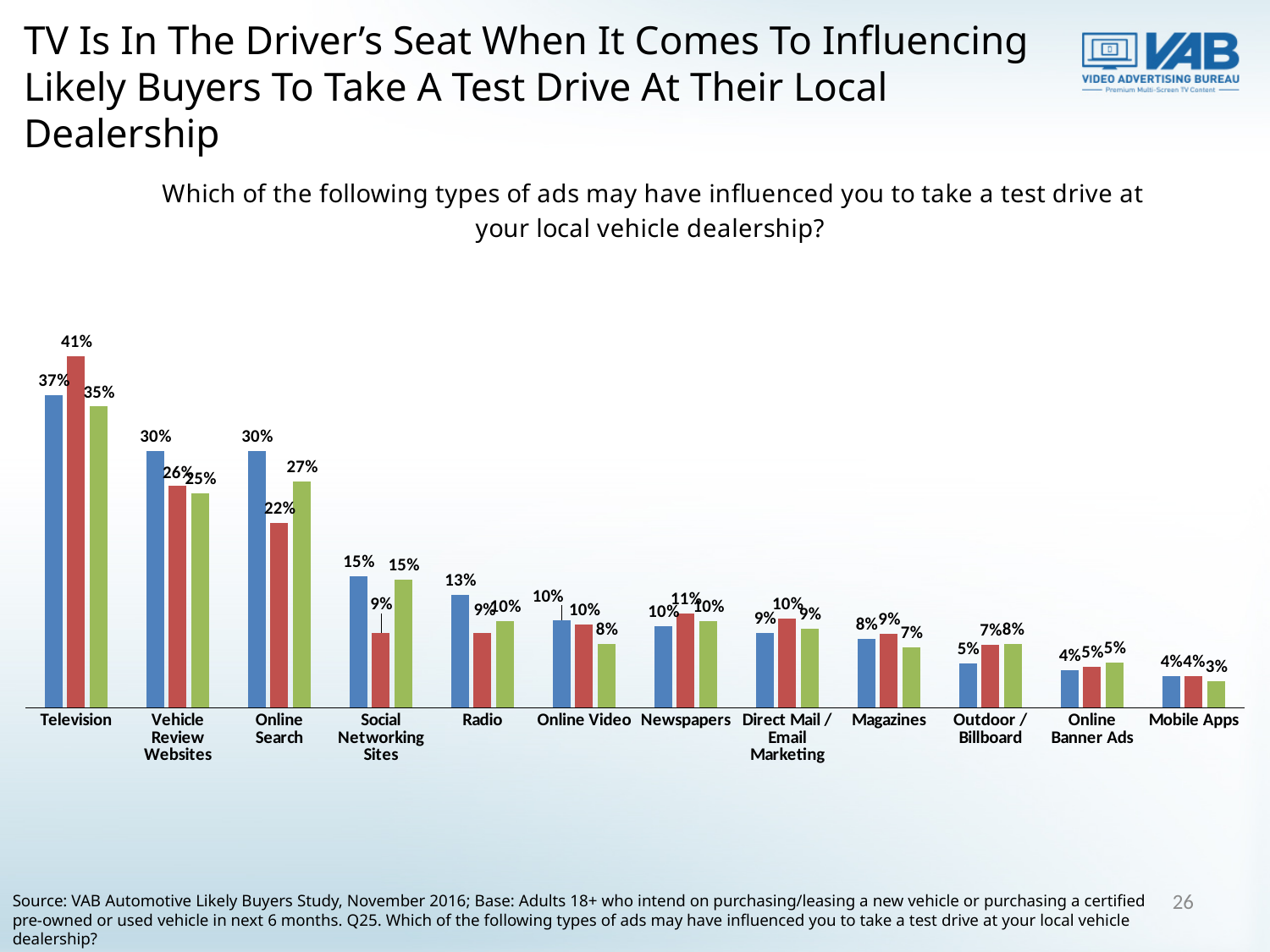
What type of chart is shown on the slide? bar chart What is the difference between the red bar and the green bar for Online Search? 5% Which category has the lowest green bar? Mobile Apps What is the difference between the blue bar for Television and the blue bar for Vehicle Review Websites? 7% What is the value of the blue bar for Online Search? 30% Which category has the highest blue bar? Television Which is larger for Radio, the blue bar or the red bar? the blue bar How many bars are shown for each category? 3 How many ad type categories are shown on the x axis? 12 What is the value of the red bar for Social Networking Sites? 9% What is the value of the green bar for Mobile Apps? 3% What is the value of the red bar for Television? 41%